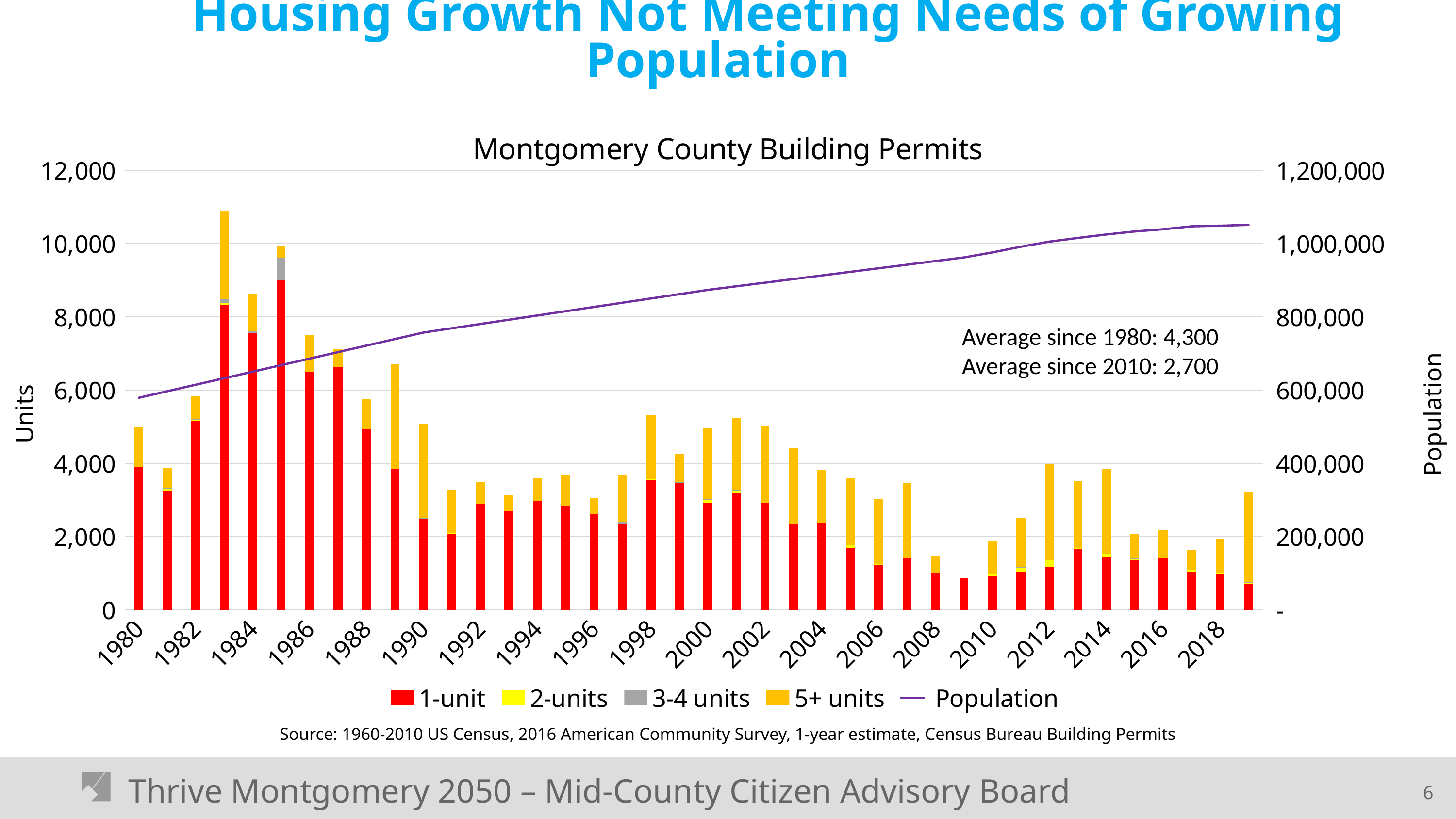
Does the Population line rise or fall from 1980 to 2019? rises Is the population value in 2000 greater or less than 800,000? greater Which year has a larger total of building permits, 1983 or 1985? 1983 According to the annotation on the chart, what is the average number of permits since 2010? 2,700 Which year has the tallest stacked bar of building permits? 1983 What kind of chart is shown on the slide? A combination chart of stacked bars and a line Is the total number of permits in 1984 greater or less than 8,000? greater Is the total number of permits in 1983 greater or less than 10,000? greater How many series does the legend list? 5 Which year has the shortest stacked bar of building permits? 2009 What is the title of the chart? Montgomery County Building Permits